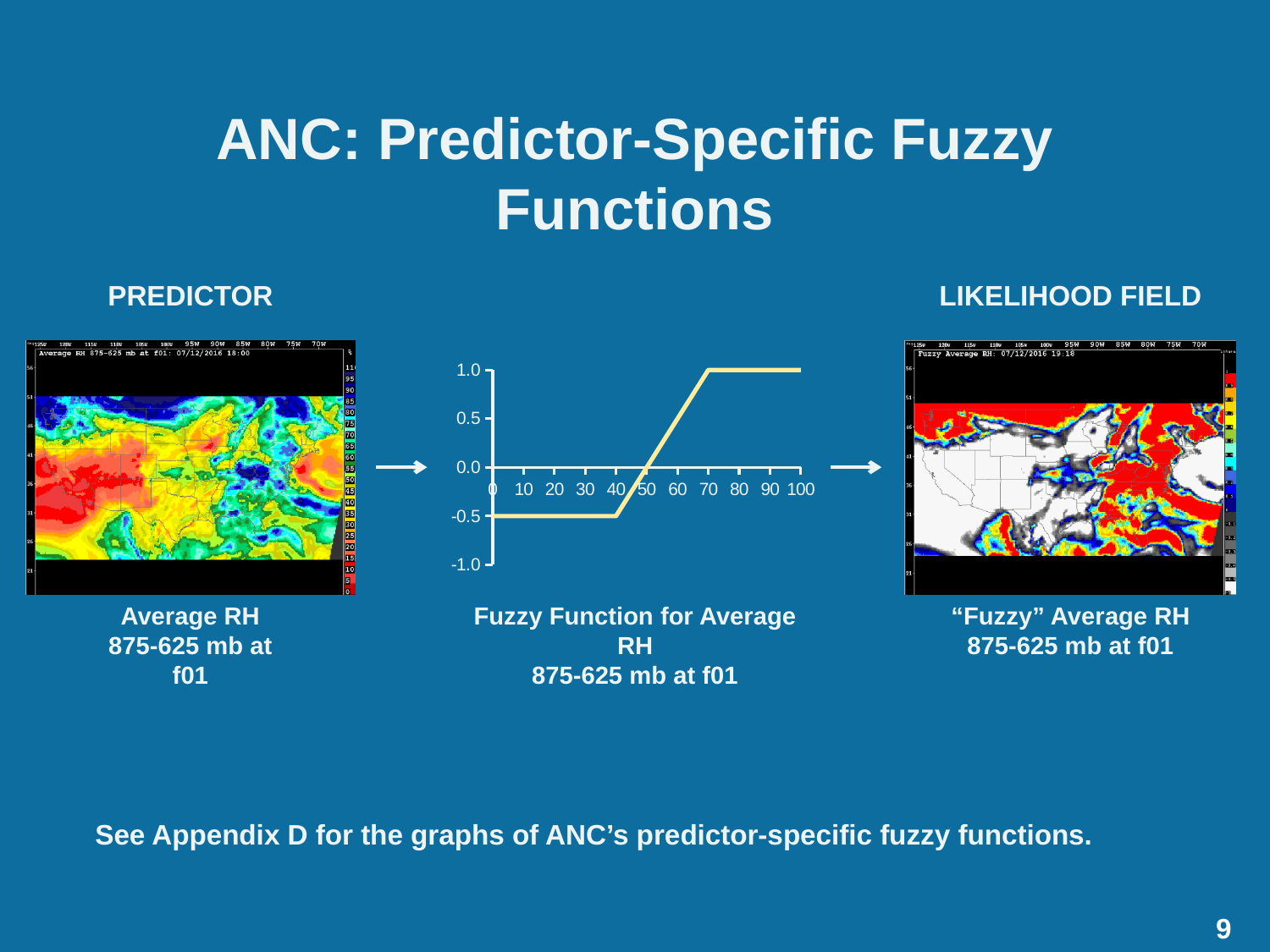
In the Fuzzy Function for Average RH chart, what is the lowest tick label shown on the y axis? -1.0 In the Fuzzy Function for Average RH chart, what is the value of the function at x = 20? -0.5 In the Fuzzy Function for Average RH chart, does the function rise or fall as x increases from 40 to 70? rise In the Fuzzy Function for Average RH chart, which has the larger function value, x = 30 or x = 90? x = 90 What kind of chart is the middle chart titled "Fuzzy Function for Average RH 875-625 mb at f01"? line chart In the Fuzzy Function for Average RH chart, what is the difference between the function's maximum value and its minimum value? 1.5 In the Fuzzy Function for Average RH chart, what is the value of the function at x = 100? 1.0 In the Fuzzy Function for Average RH chart, what is the value of the function at x = 80? 1.0 In the Fuzzy Function for Average RH chart, what is the lowest value the function reaches? -0.5 In the Fuzzy Function for Average RH chart, what is the highest value the function reaches? 1.0 In the Fuzzy Function for Average RH chart, at what x value does the function cross 0.0? 50 In the Fuzzy Function for Average RH chart, is the value at x = 60 greater or less than 0.0? greater